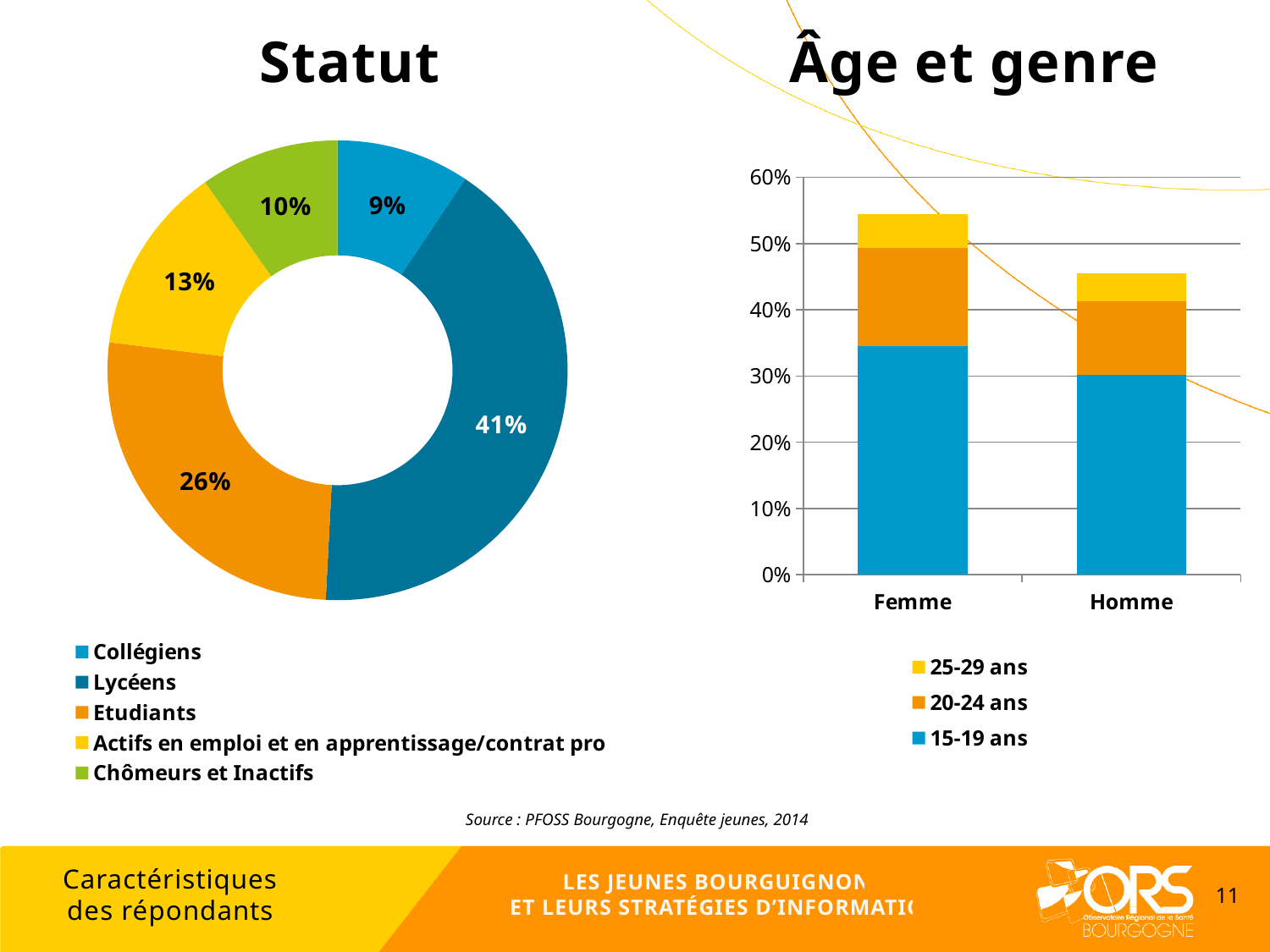
In the Statut chart, what percentage is shown for Collégiens? 9% In the Statut chart, which is larger: the share of Actifs en emploi et en apprentissage/contrat pro or the share of Chômeurs et Inactifs? Actifs en emploi et en apprentissage/contrat pro In the Âge et genre chart, is the total height of the Homme bar greater or less than 50%? less In the Âge et genre chart, is the total height of the Femme bar greater or less than 50%? greater In the Statut chart, which category has the largest share? Lycéens In the Statut chart, which category has the smallest share? Collégiens How many series does the legend of the Âge et genre chart list? 3 How many categories does the legend of the Statut chart list? 5 In the Statut chart, what is the difference between the shares of Lycéens and Etudiants? 15% What kind of chart is the Âge et genre chart? Stacked bar chart In the Statut chart, what percentage is shown for Lycéens? 41% In the Statut chart, what percentage is shown for Etudiants? 26%